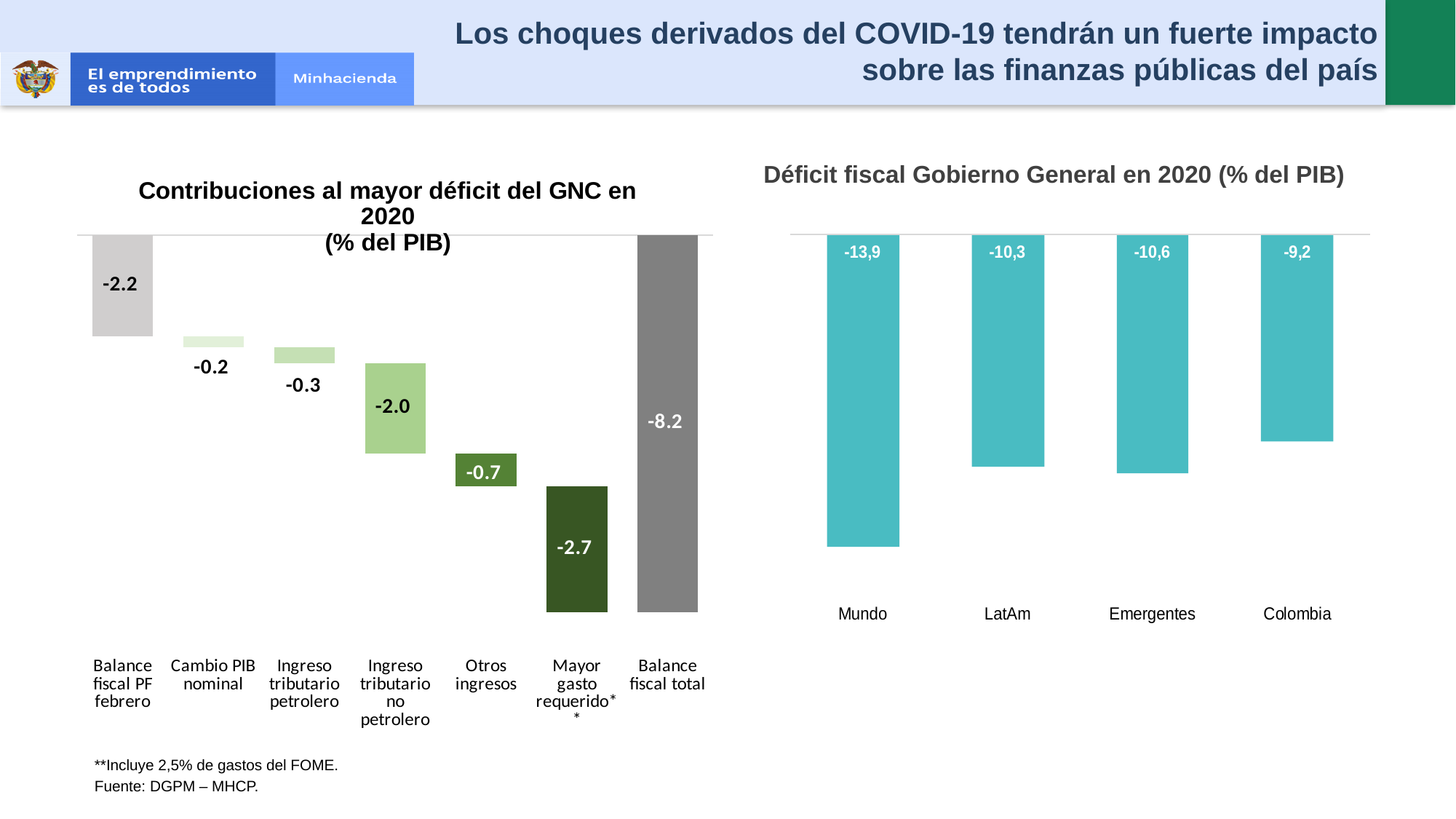
In the chart 'Déficit fiscal Gobierno General en 2020 (% del PIB)', which category has the smallest deficit (least negative value)? Colombia In the chart 'Déficit fiscal Gobierno General en 2020 (% del PIB)', which category has the largest deficit (most negative value)? Mundo What kind of chart is 'Déficit fiscal Gobierno General en 2020 (% del PIB)'? Bar chart In the chart 'Contribuciones al mayor déficit del GNC en 2020 (% del PIB)', which contribution has the smallest magnitude? Cambio PIB nominal In the chart 'Déficit fiscal Gobierno General en 2020 (% del PIB)', how many categories are shown? 4 In the chart 'Contribuciones al mayor déficit del GNC en 2020 (% del PIB)', what is the value for 'Balance fiscal total'? -8.2 In the chart 'Déficit fiscal Gobierno General en 2020 (% del PIB)', what is the value for Colombia? -9,2 In the chart 'Contribuciones al mayor déficit del GNC en 2020 (% del PIB)', what is the value for 'Ingreso tributario no petrolero'? -2.0 In the chart 'Déficit fiscal Gobierno General en 2020 (% del PIB)', what is the value for Mundo? -13,9 In the chart 'Déficit fiscal Gobierno General en 2020 (% del PIB)', what is the difference between the values for Mundo and Colombia? 4,7 In the chart 'Contribuciones al mayor déficit del GNC en 2020 (% del PIB)', which has a larger magnitude: 'Otros ingresos' or 'Ingreso tributario petrolero'? Otros ingresos In the chart 'Contribuciones al mayor déficit del GNC en 2020 (% del PIB)', what is the value for 'Mayor gasto requerido'? -2.7